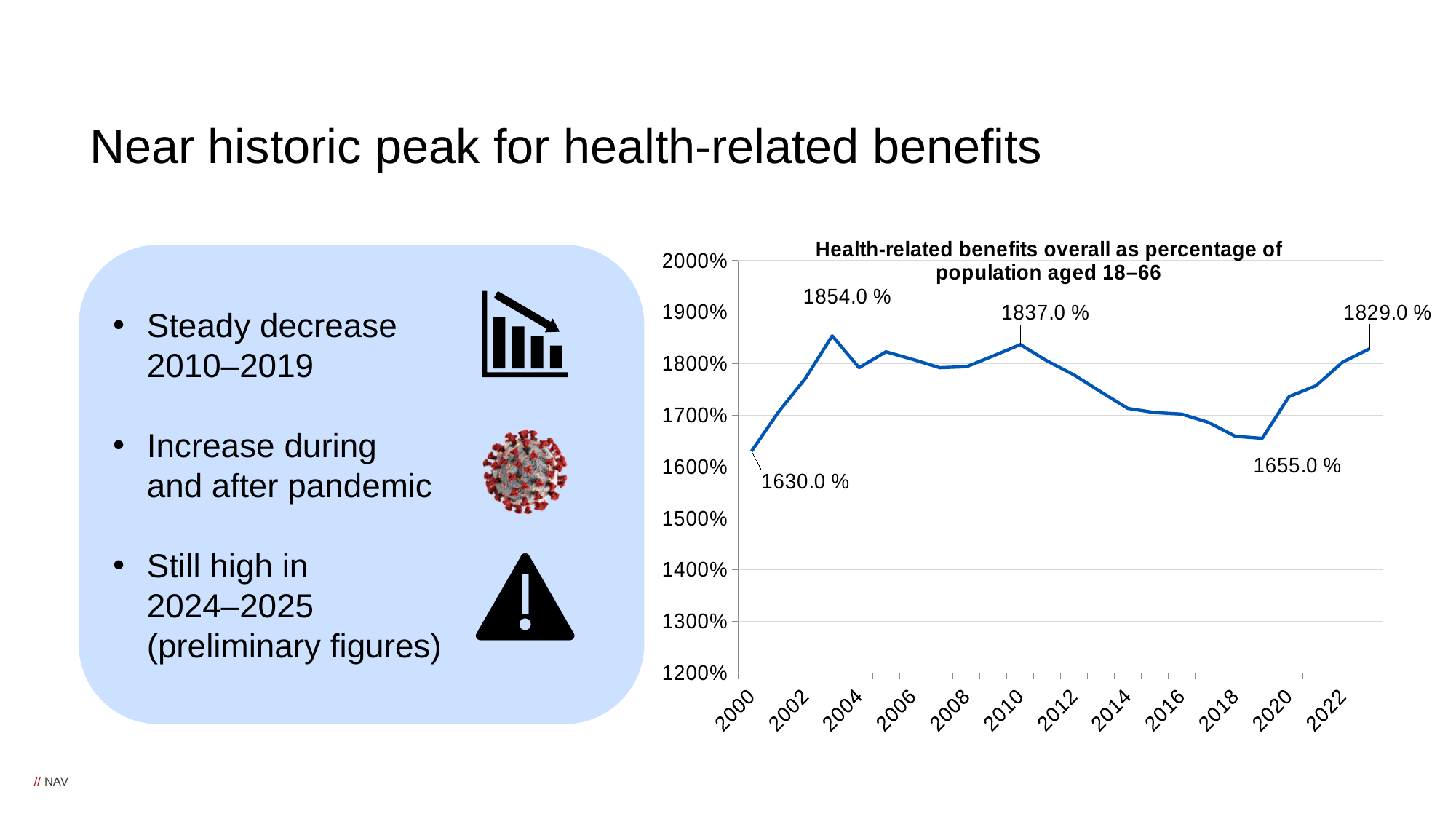
What is the value labelled for the year 2010? 1837.0 % Does the line rise or fall between 2010 and 2019? fall What is the lowest labelled value on the chart? 1630.0 % Which year has the larger value, 2000 or 2010? 2010 What is the value labelled at the low point between 2018 and 2020? 1655.0 % What is the difference between the highest labelled value (1854.0 %) and the value for 2000 (1630.0 %)? 224.0 % What is the highest labelled value on the chart? 1854.0 % What is the difference between the value for 2010 and the low point labelled 1655.0 %? 182.0 % Is the value for 2016 greater or less than 1800%? less What is the value labelled for the year 2000? 1630.0 % What is the title of the chart? Health-related benefits overall as percentage of population aged 18–66 What type of chart is shown on the slide? line chart